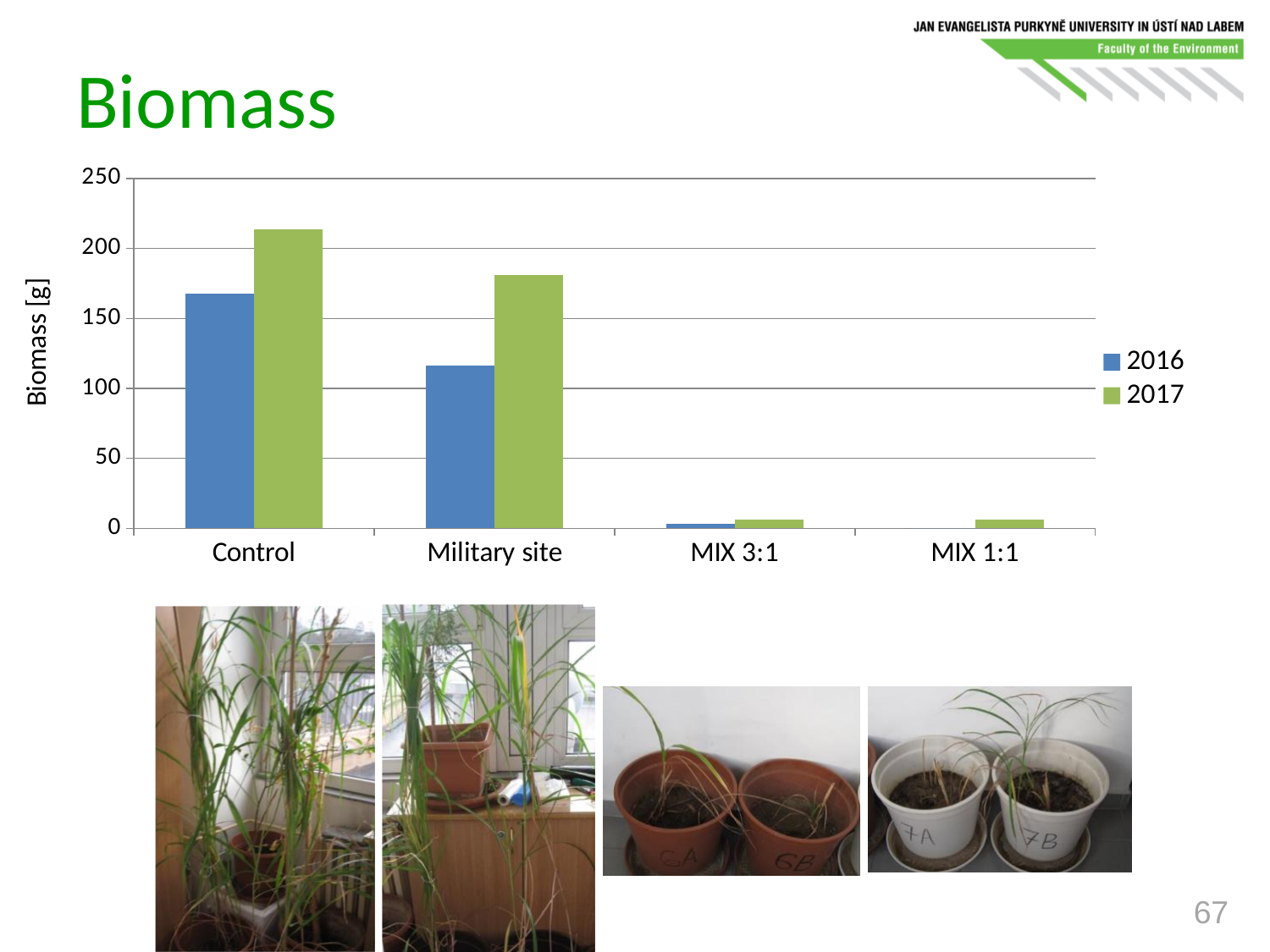
Which category has the highest biomass in 2016? Control How many series does the legend list? 2 Is the 2017 biomass for Control greater or less than 200? greater How many categories are shown on the x axis? 4 Which has the larger 2016 biomass, Control or Military site? Control Which category has the lowest biomass in 2016? MIX 1:1 Which category has the highest biomass in 2017? Control What is the label of the y axis? Biomass [g] What kind of chart is shown on the slide? bar chart For the Control category, which year has the larger biomass, 2016 or 2017? 2017 Is the 2016 biomass for Military site greater or less than 150? less Which colour represents the 2017 series? green